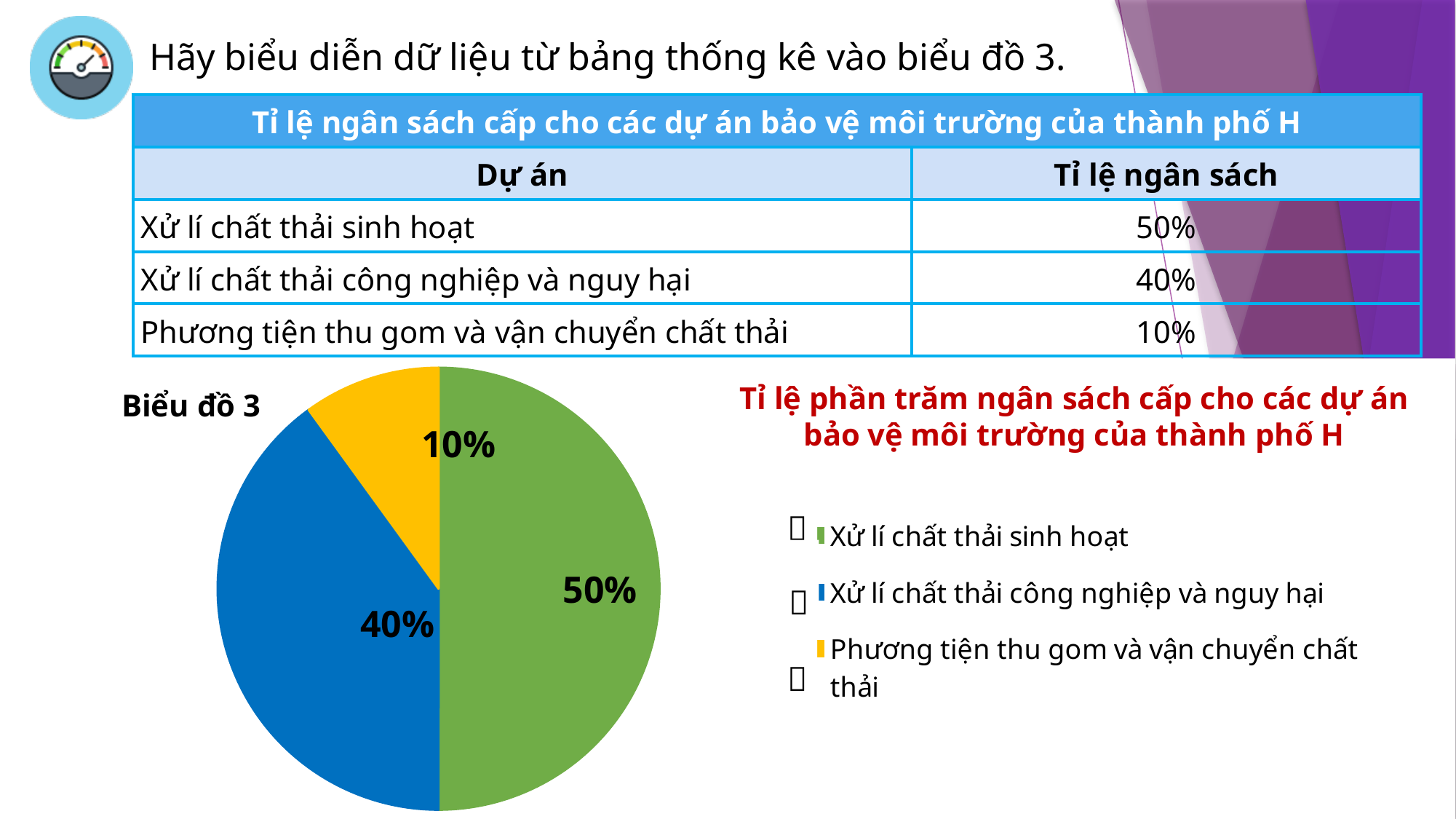
Which category has the largest slice of the pie? Xử lí chất thải sinh hoạt What is the difference between the shares for Xử lí chất thải công nghiệp và nguy hại and Phương tiện thu gom và vận chuyển chất thải? 30% What share of the pie does Xử lí chất thải sinh hoạt take? 50% What is the title of the pie chart shown in red text? Tỉ lệ phần trăm ngân sách cấp cho các dự án bảo vệ môi trường của thành phố H What kind of chart is Biểu đồ 3? pie chart What is the difference between the shares for Xử lí chất thải sinh hoạt and Xử lí chất thải công nghiệp và nguy hại? 10% What colour is the slice for Xử lí chất thải sinh hoạt? green Which category has the smallest slice of the pie? Phương tiện thu gom và vận chuyển chất thải What is the value shown for Xử lí chất thải công nghiệp và nguy hại? 40% Which is larger: the slice for Xử lí chất thải công nghiệp và nguy hại or the slice for Phương tiện thu gom và vận chuyển chất thải? Xử lí chất thải công nghiệp và nguy hại How many slices does the pie chart have? 3 What is the value shown for Phương tiện thu gom và vận chuyển chất thải? 10%